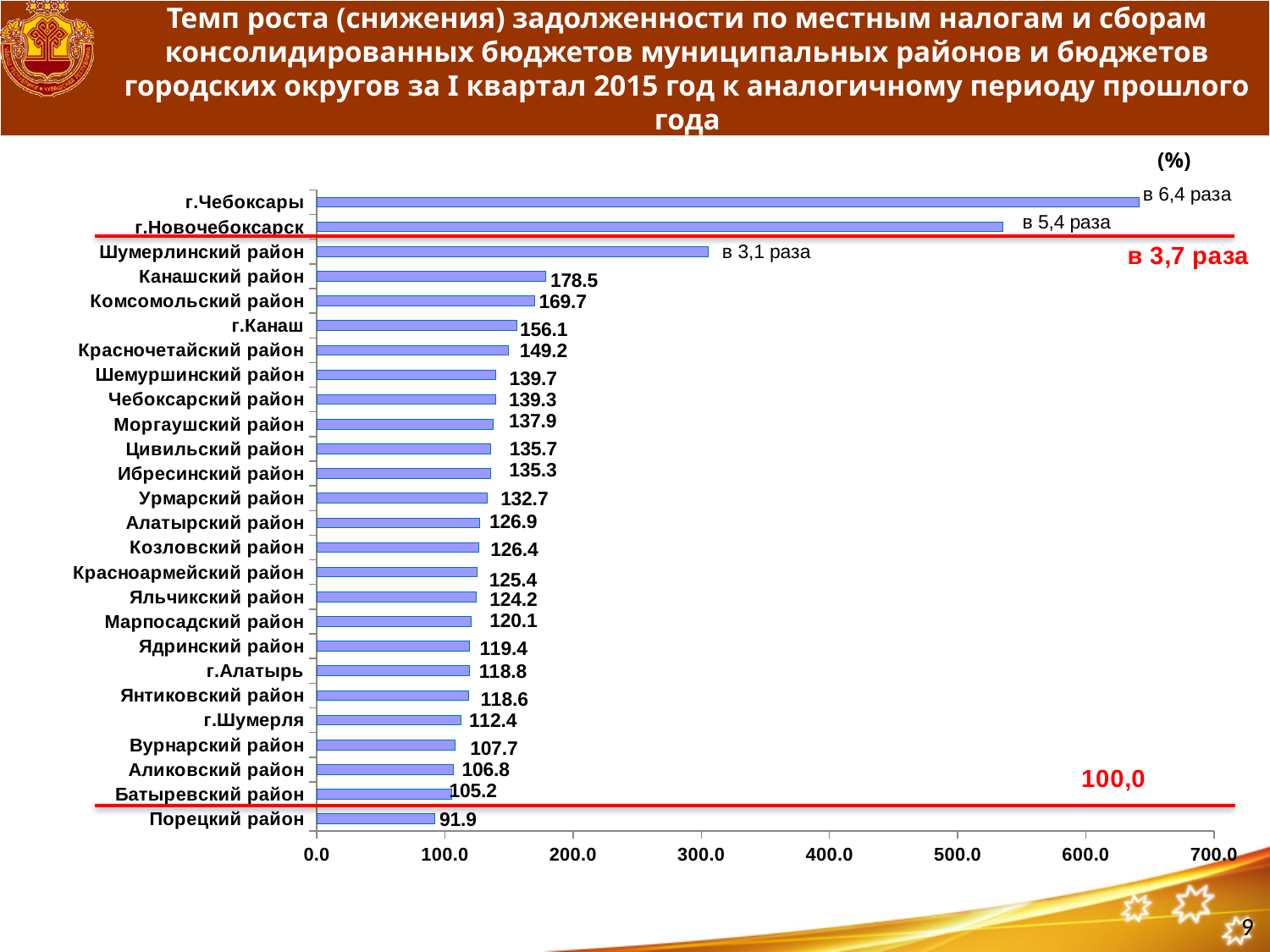
Which category has the highest value? г.Чебоксары What is the difference between the values for Канашский район and Комсомольский район? 8.8 What is the value for г.Шумерля? 112.4 What is the value for Канашский район? 178.5 Is the value for г.Чебоксары greater or less than 600.0? greater Which category has the lowest value? Порецкий район How many categories are shown in the chart? 26 Which is larger, the value for г.Канаш or the value for Урмарский район? г.Канаш What kind of chart is shown on the slide? bar chart What is the value for Порецкий район? 91.9 What label is shown next to the bar for г.Чебоксары? в 6,4 раза Is the value for Шумерлинский район greater or less than 400.0? less